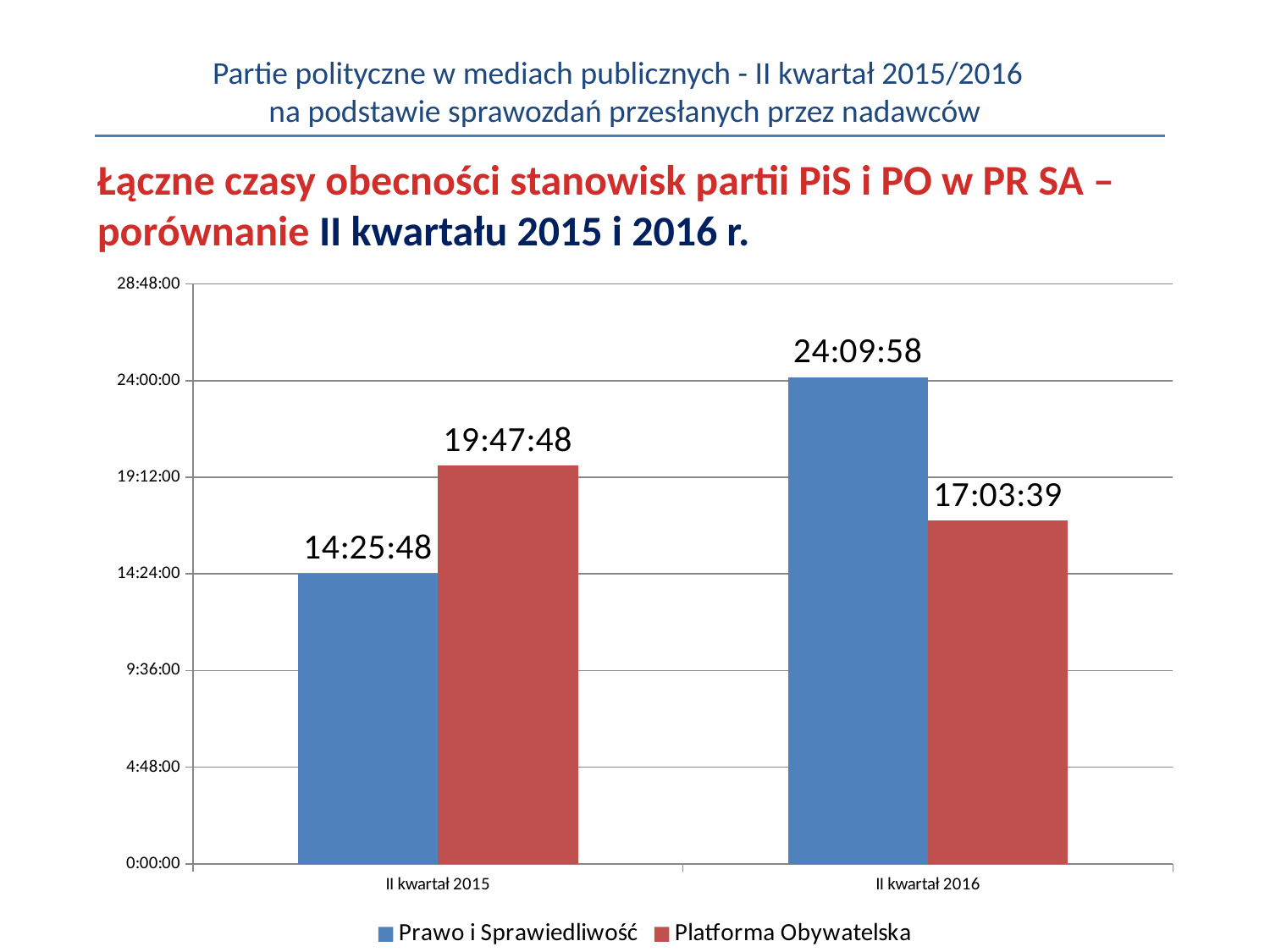
What is the value for Platforma Obywatelska in II kwartał 2016? 17:03:39 Does the value for Platforma Obywatelska rise or fall from II kwartał 2015 to II kwartał 2016? fall What is the value for Prawo i Sprawiedliwość in II kwartał 2016? 24:09:58 In II kwartał 2015, which party has the larger value, Prawo i Sprawiedliwość or Platforma Obywatelska? Platforma Obywatelska What is the difference between Prawo i Sprawiedliwość and Platforma Obywatelska in II kwartał 2016? 7:06:19 What is the value for Prawo i Sprawiedliwość in II kwartał 2015? 14:25:48 Which bar has the highest value on the chart? Prawo i Sprawiedliwość, II kwartał 2016 How many series does the legend list? 2 What is the difference between Platforma Obywatelska and Prawo i Sprawiedliwość in II kwartał 2015? 5:22:00 Is the value for Platforma Obywatelska in II kwartał 2016 greater or less than 19:12:00? less Which bar has the lowest value on the chart? Prawo i Sprawiedliwość, II kwartał 2015 What kind of chart is shown on the slide? bar chart